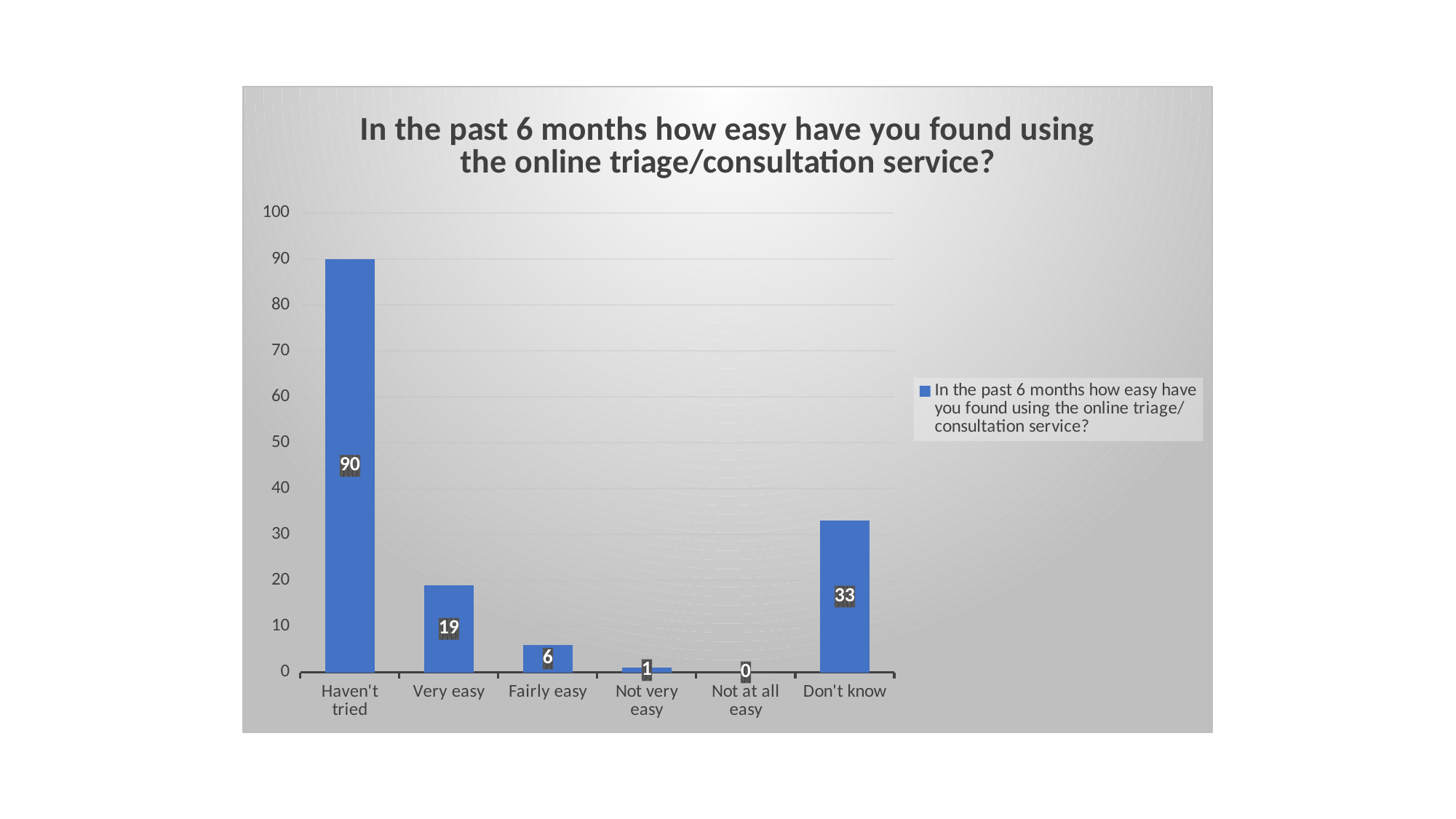
What is the value for "Haven't tried"? 90 What kind of chart is shown on the slide? Bar chart What is the value for "Don't know"? 33 Which category has the lowest value? Not at all easy How many categories are shown on the x axis? 6 Which is larger, the value for "Very easy" or the value for "Don't know"? Don't know What is the difference between the values for "Haven't tried" and "Don't know"? 57 What is the title of the chart? In the past 6 months how easy have you found using the online triage/consultation service? Which category has the highest value? Haven't tried What is the value for "Very easy"? 19 What is the value for "Not at all easy"? 0 What is the difference between the values for "Very easy" and "Fairly easy"? 13